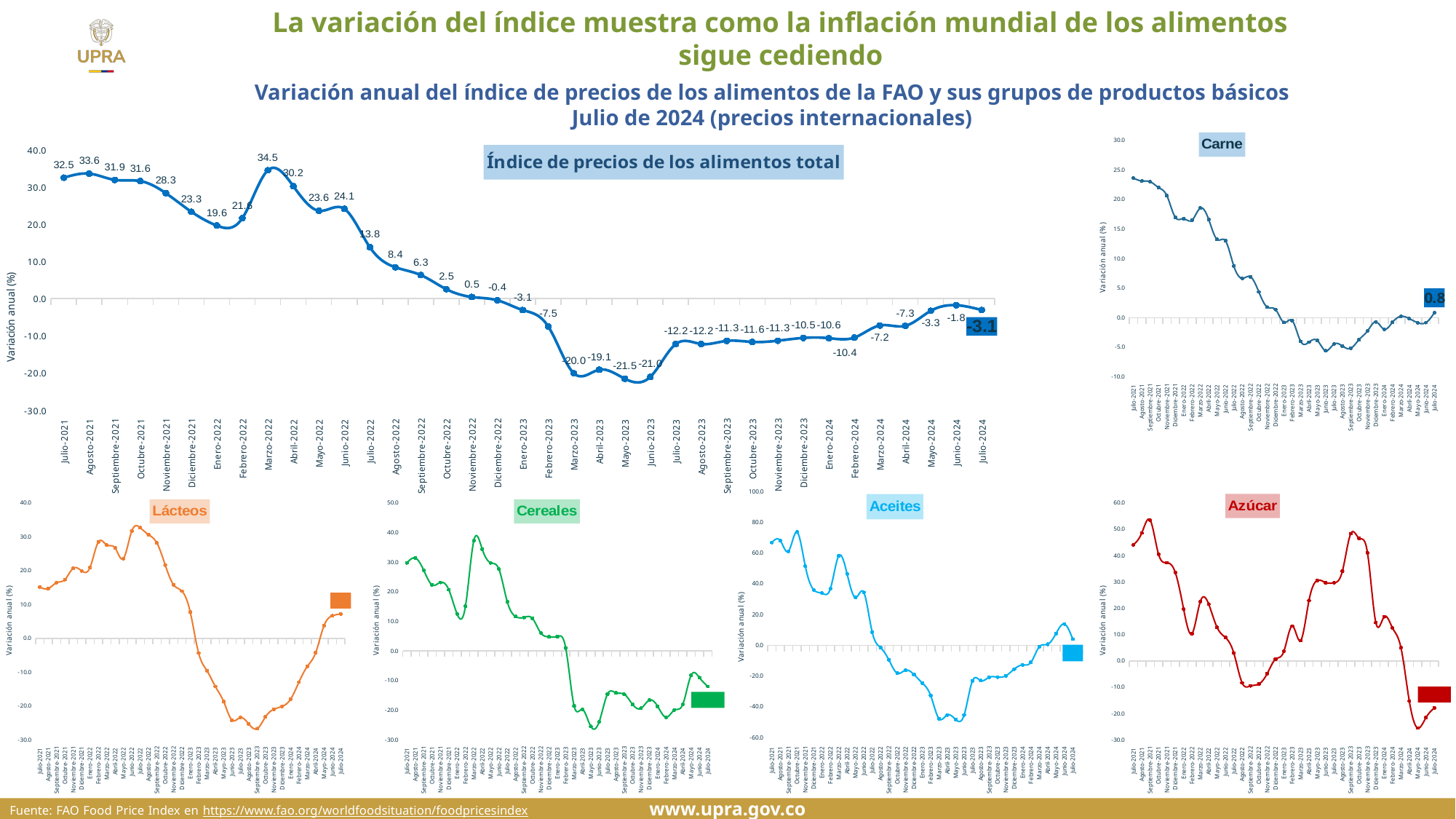
In the 'Carne' chart, is the value for Julio-2021 greater or less than 20.0? greater In the 'Carne' chart, what is the value for Julio-2024? 0.8 In the 'Índice de precios de los alimentos total' chart, which is larger, the value for Agosto-2021 or Julio-2021? Agosto-2021 In the 'Índice de precios de los alimentos total' chart, what is the value for Julio-2024? -3.1 In the 'Índice de precios de los alimentos total' chart, how many monthly data points are plotted? 37 In the 'Índice de precios de los alimentos total' chart, which month has the lowest value? Mayo-2023 In the 'Azúcar' chart, is the value for Julio-2024 greater or less than -10.0? less In the 'Índice de precios de los alimentos total' chart, what is the difference between the values for Julio-2021 and Julio-2024? 35.6 What kind of chart is the 'Índice de precios de los alimentos total' chart? Line chart In the 'Índice de precios de los alimentos total' chart, which month has the highest value? Marzo-2022 In the 'Índice de precios de los alimentos total' chart, do the values generally rise or fall from Julio-2021 to Mayo-2023? Fall In the 'Índice de precios de los alimentos total' chart, what is the value for Marzo-2022? 34.5